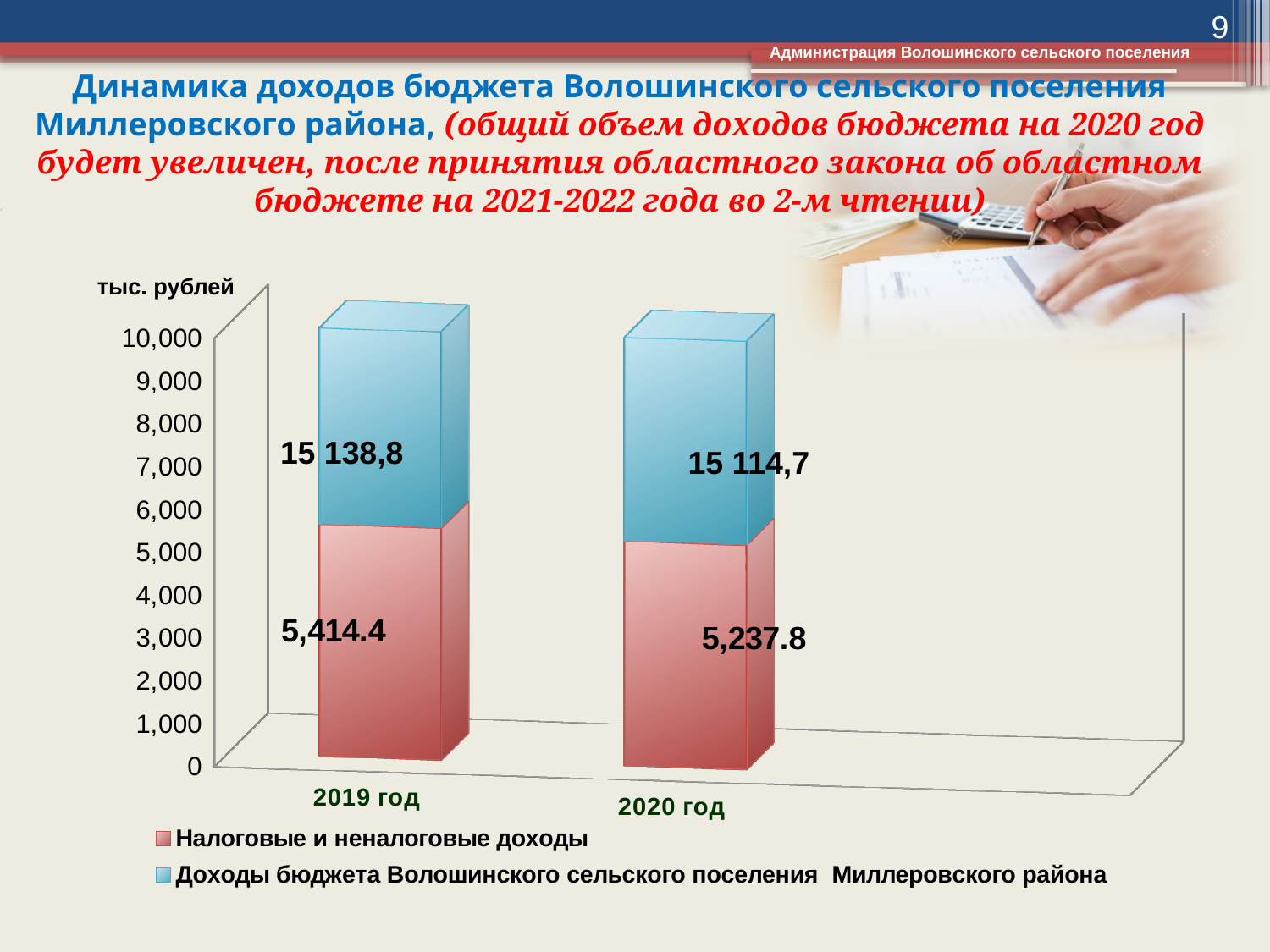
How many series does the chart legend list? 2 What type of chart is shown on the slide? bar chart Which year has the higher value for "Налоговые и неналоговые доходы", 2019 год or 2020 год? 2019 год Which colour represents "Налоговые и неналоговые доходы" in the chart legend? red What value is labelled on the blue segment (Доходы бюджета Волошинского сельского поселения Миллеровского района) for 2019 год? 15 138,8 How many year categories are shown on the x axis of the chart? 2 Do the "Налоговые и неналоговые доходы" values rise or fall from 2019 год to 2020 год? fall What is the value of "Налоговые и неналоговые доходы" for 2020 год? 5,237.8 What is the difference between the "Налоговые и неналоговые доходы" values for 2019 год and 2020 год? 176.6 What unit is shown above the vertical axis of the chart? тыс. рублей What is the value of "Налоговые и неналоговые доходы" for 2019 год? 5,414.4 What value is labelled on the blue segment (Доходы бюджета Волошинского сельского поселения Миллеровского района) for 2020 год? 15 114,7